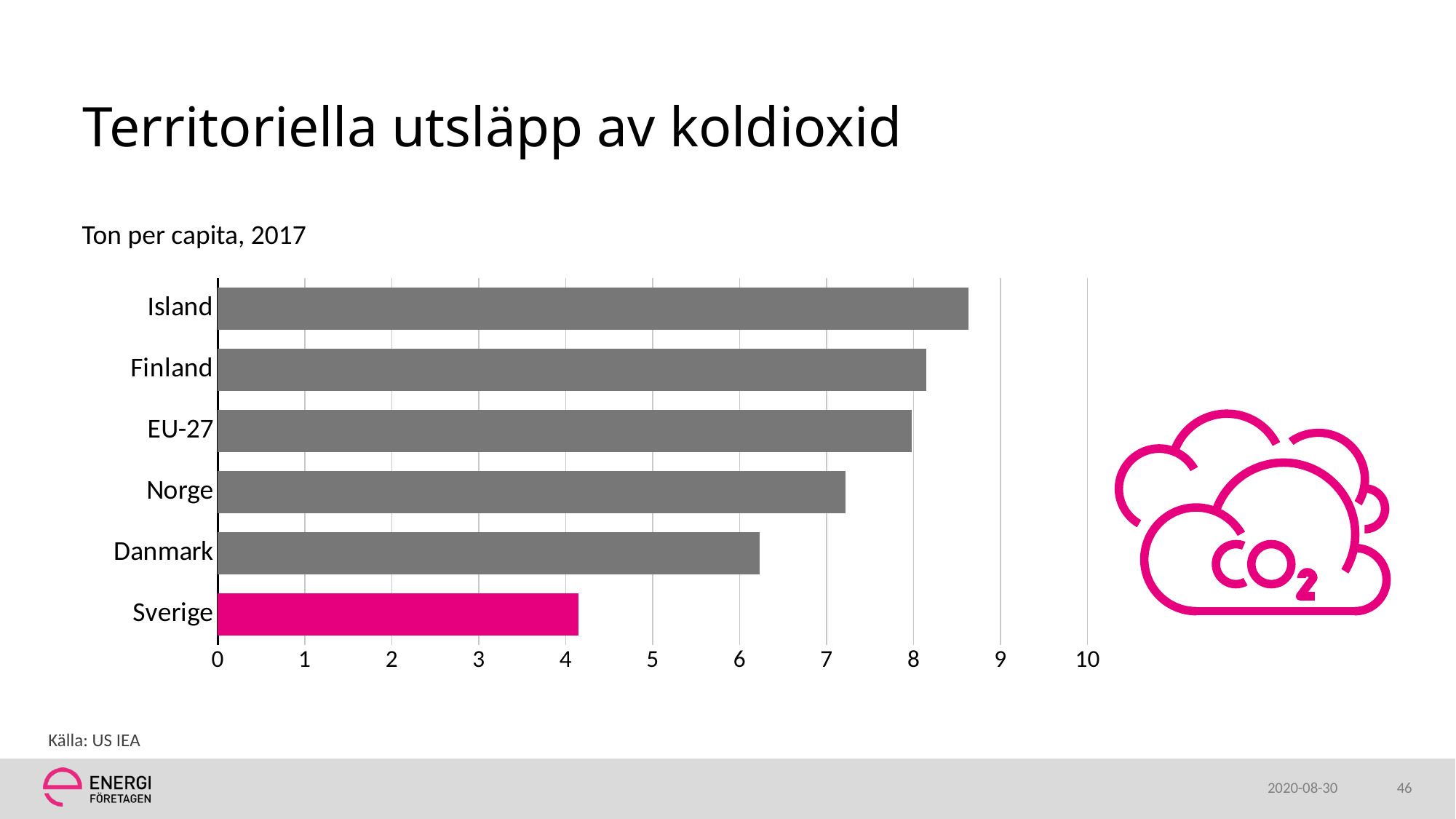
Which has the larger value, Norge or Danmark? Norge Is the value for Island greater or less than 8? greater Which country or region has the highest CO2 emissions per capita in the chart? Island Is the value for Danmark greater or less than 7? less Which country or region has the lowest CO2 emissions per capita in the chart? Sverige Which bar in the chart is highlighted in pink? Sverige What kind of chart is shown on the slide? bar chart Which has the larger value, Sverige or Danmark? Danmark Is the value for Island greater or less than 9? less How many countries or regions are shown in the chart? 6